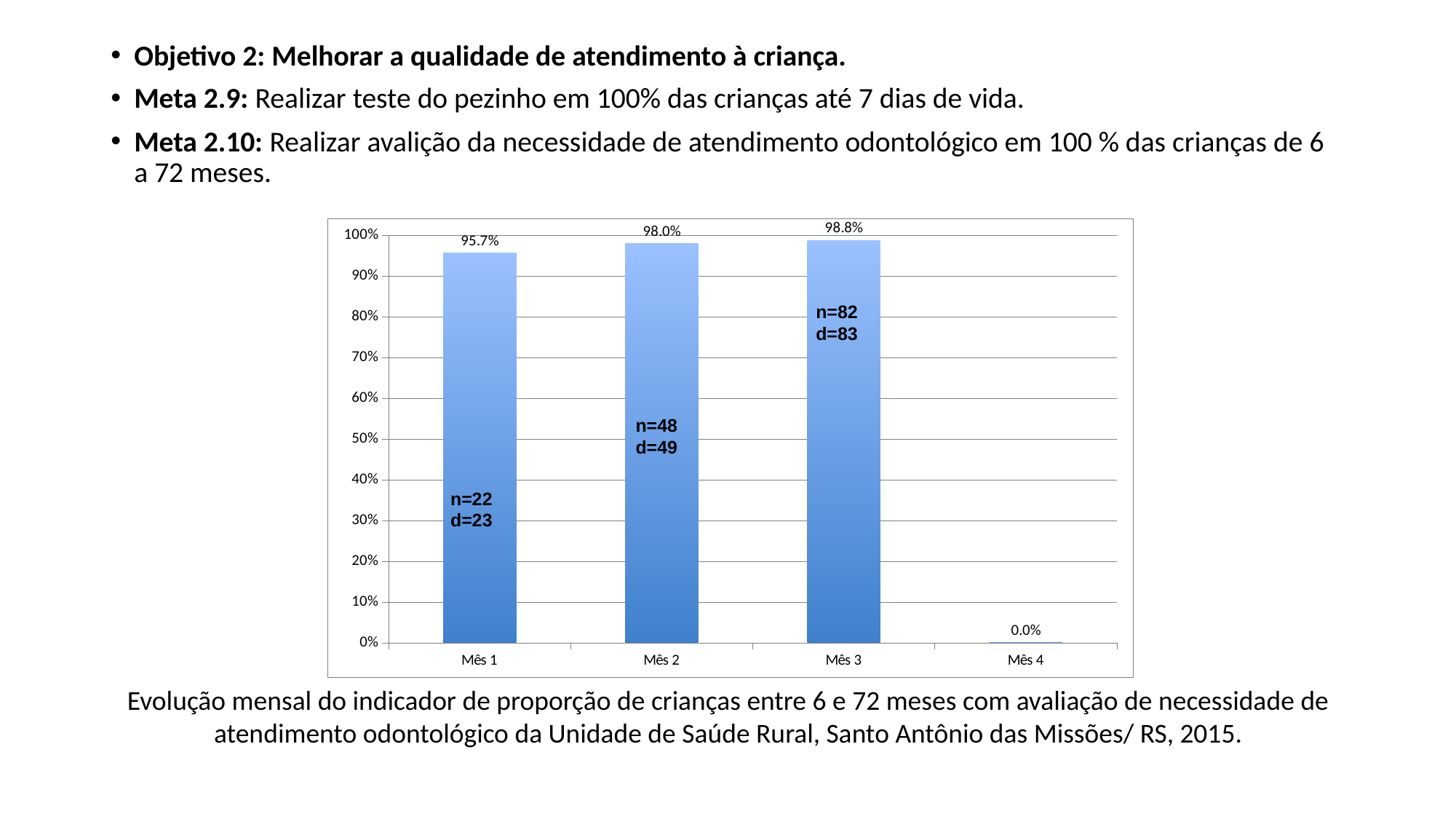
What is the difference between the values for Mês 3 and Mês 1? 3.1% What kind of chart is shown on the slide? bar chart What are the n and d values annotated on the bar for Mês 2? n=48, d=49 What is the value for Mês 2? 98.0% Which is larger, the value for Mês 2 or the value for Mês 1? Mês 2 Which month has the lowest value? Mês 4 What is the value for Mês 4? 0.0% Which month has the highest value? Mês 3 What is the value for Mês 1? 95.7% Is the value for Mês 1 greater or less than 90%? greater How many months are shown on the x axis? 4 What is the value for Mês 3? 98.8%